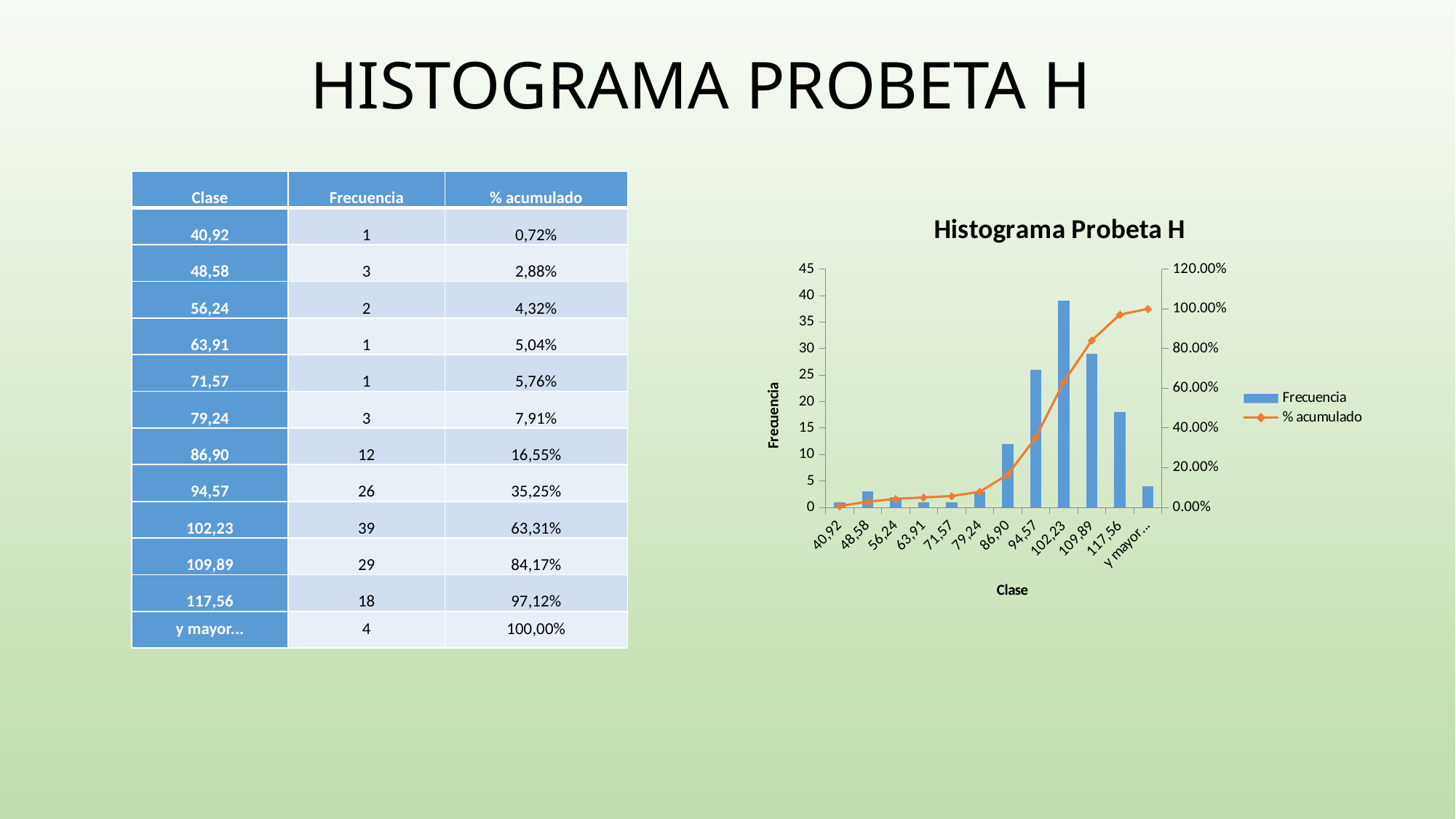
What is the Frecuencia for class 94,57? 26 What is the title of the chart? Histograma Probeta H How many series does the chart legend list? 2 Which class has the highest Frecuencia in the chart? 102,23 Which is larger, the Frecuencia for class 117,56 or for class 94,57? 94,57 What is the Frecuencia for class 102,23? 39 What is the difference in Frecuencia between class 102,23 and class 109,89? 10 Is the Frecuencia for class 86,90 greater or less than 15? less How many classes (categories) are plotted along the x axis of the chart? 12 What type of chart is shown on the slide? Bar chart with a line Is the Frecuencia for class 109,89 greater or less than 25? greater What is the % acumulado for class 109,89? 84,17%